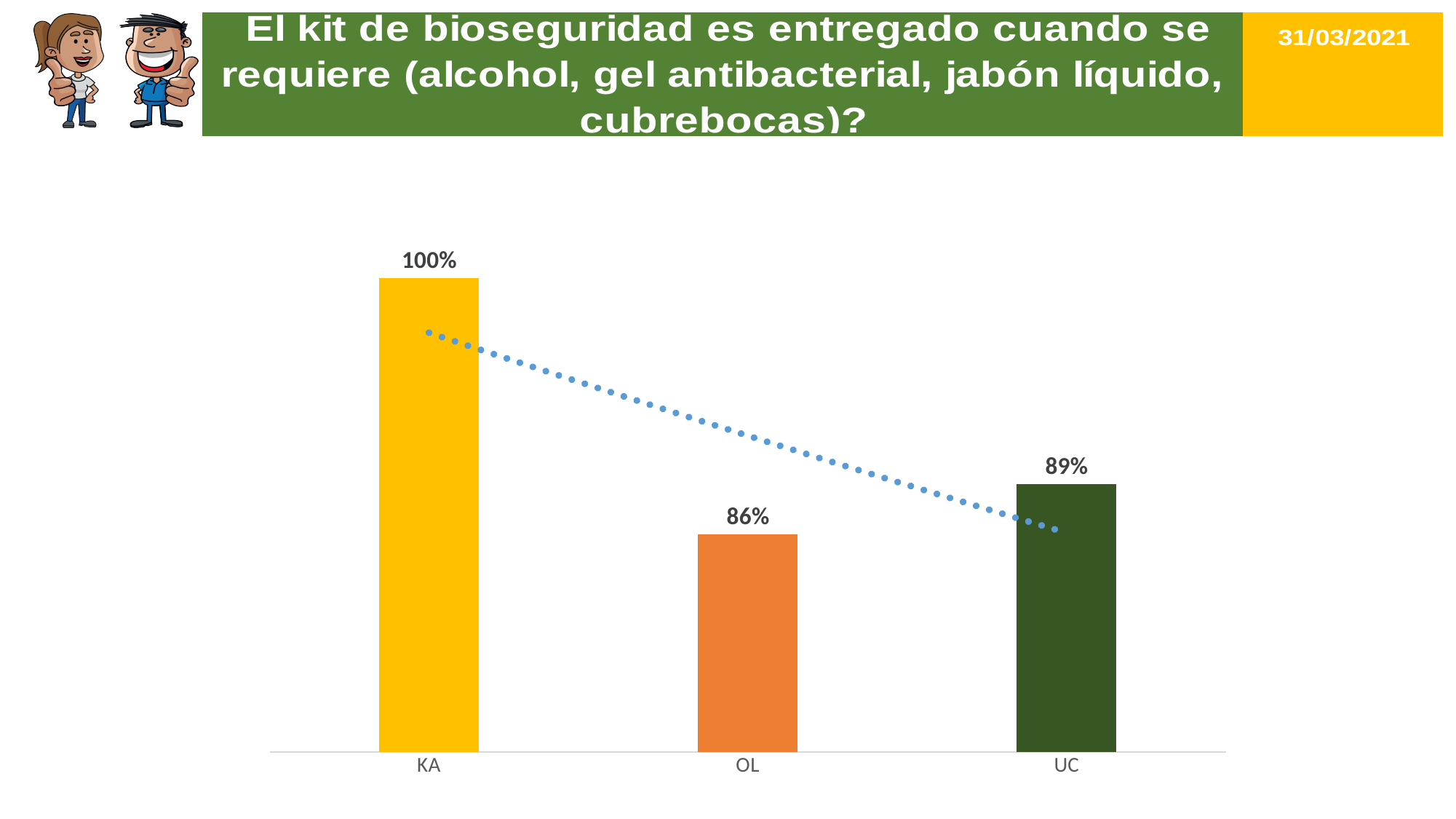
What is the difference between the values for UC and OL? 3% What is the value for KA? 100% What is the value for OL? 86% Which is larger, the value for UC or the value for OL? UC Which category has the lowest value? OL What date is shown in the top right corner of the slide? 31/03/2021 What is the value for UC? 89% What colour is the bar for OL? orange Which category has the highest value? KA What kind of chart is shown on the slide? bar chart What is the difference between the values for KA and OL? 14% How many categories are shown on the x axis? 3